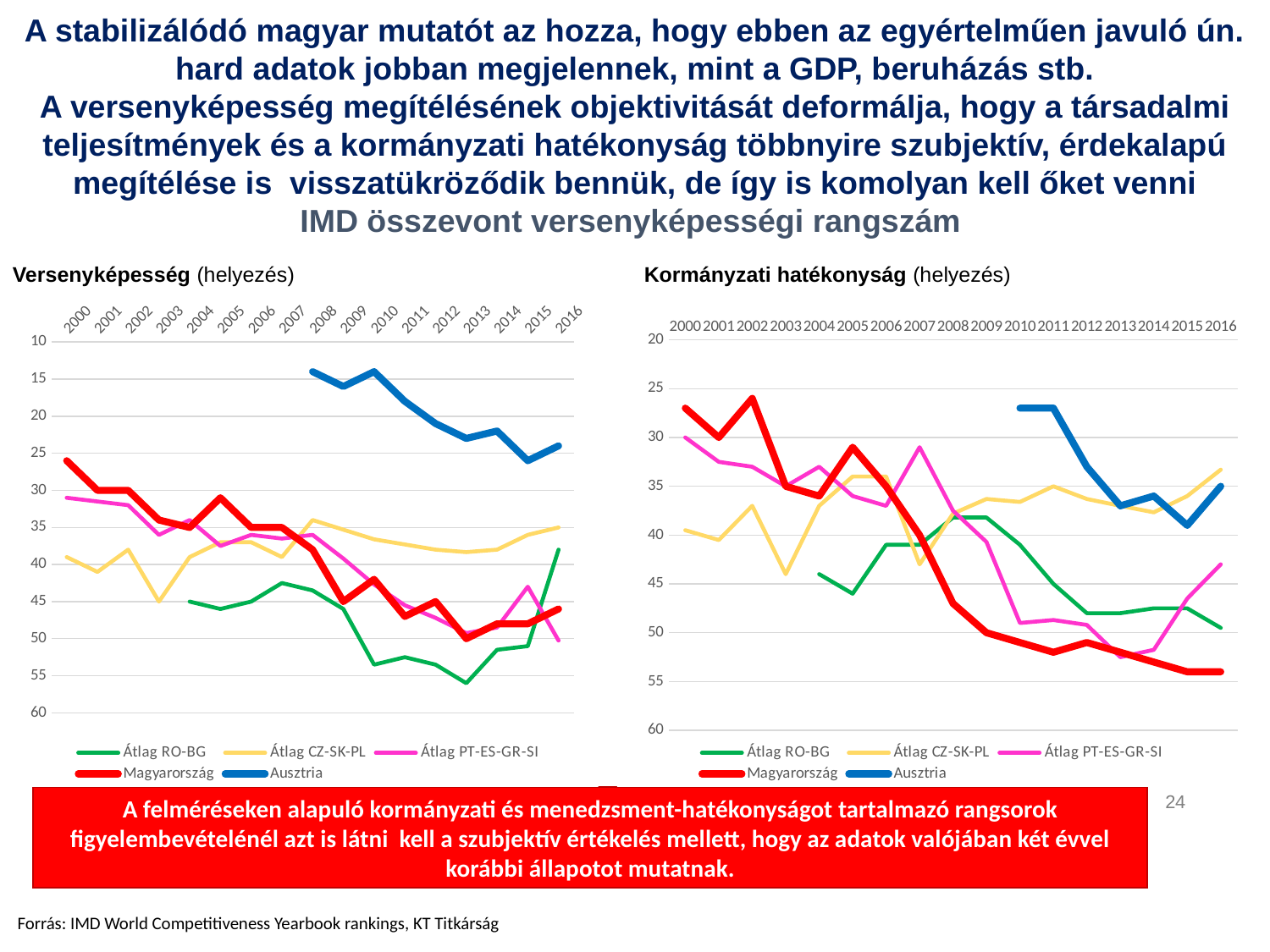
In the 'Versenyképesség (helyezés)' chart, which series has the smaller value in 2016: Ausztria or Magyarország? Ausztria In the 'Kormányzati hatékonyság (helyezés)' chart, do the values for Magyarország rise or fall from 2000 to 2016? rise In the 'Versenyképesség (helyezés)' chart, is the value for Átlag RO-BG in 2010 greater or less than 50? greater What kind of chart is the 'Versenyképesség (helyezés)' chart on the left? line chart In the 'Kormányzati hatékonyság (helyezés)' chart, is the value for Átlag CZ-SK-PL in 2003 greater or less than 40? greater In the 'Kormányzati hatékonyság (helyezés)' chart, is the value for Magyarország in 2016 greater or less than 50? greater What is the title shown above the two charts? IMD összevont versenyképességi rangszám How many series does the legend of the 'Kormányzati hatékonyság (helyezés)' chart list? 5 How many years are shown on the x axis of the 'Versenyképesség (helyezés)' chart? 17